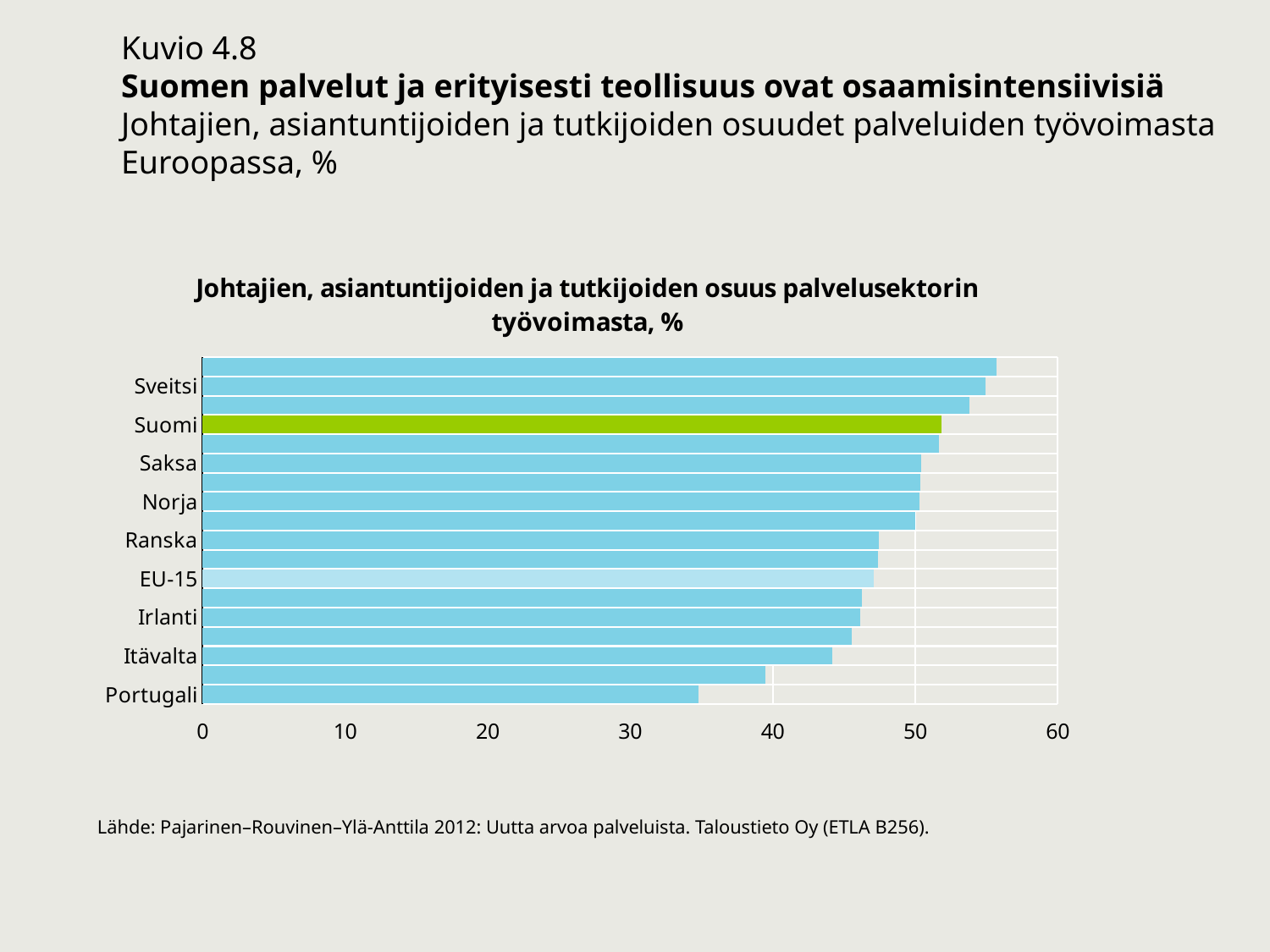
Which country's bar is highlighted in green? Suomi Is the value for Ranska greater or less than 50? less Is the value for Suomi greater or less than 50? greater Is the value for Sveitsi greater or less than 50? greater What is the maximum value shown on the horizontal axis? 60 Which has the larger value, Sveitsi or Suomi? Sveitsi Which labelled country has the lowest share of managers, experts and researchers in the service-sector workforce? Portugali What kind of chart is shown on the slide? bar chart Which has the larger value, Suomi or Portugali? Suomi